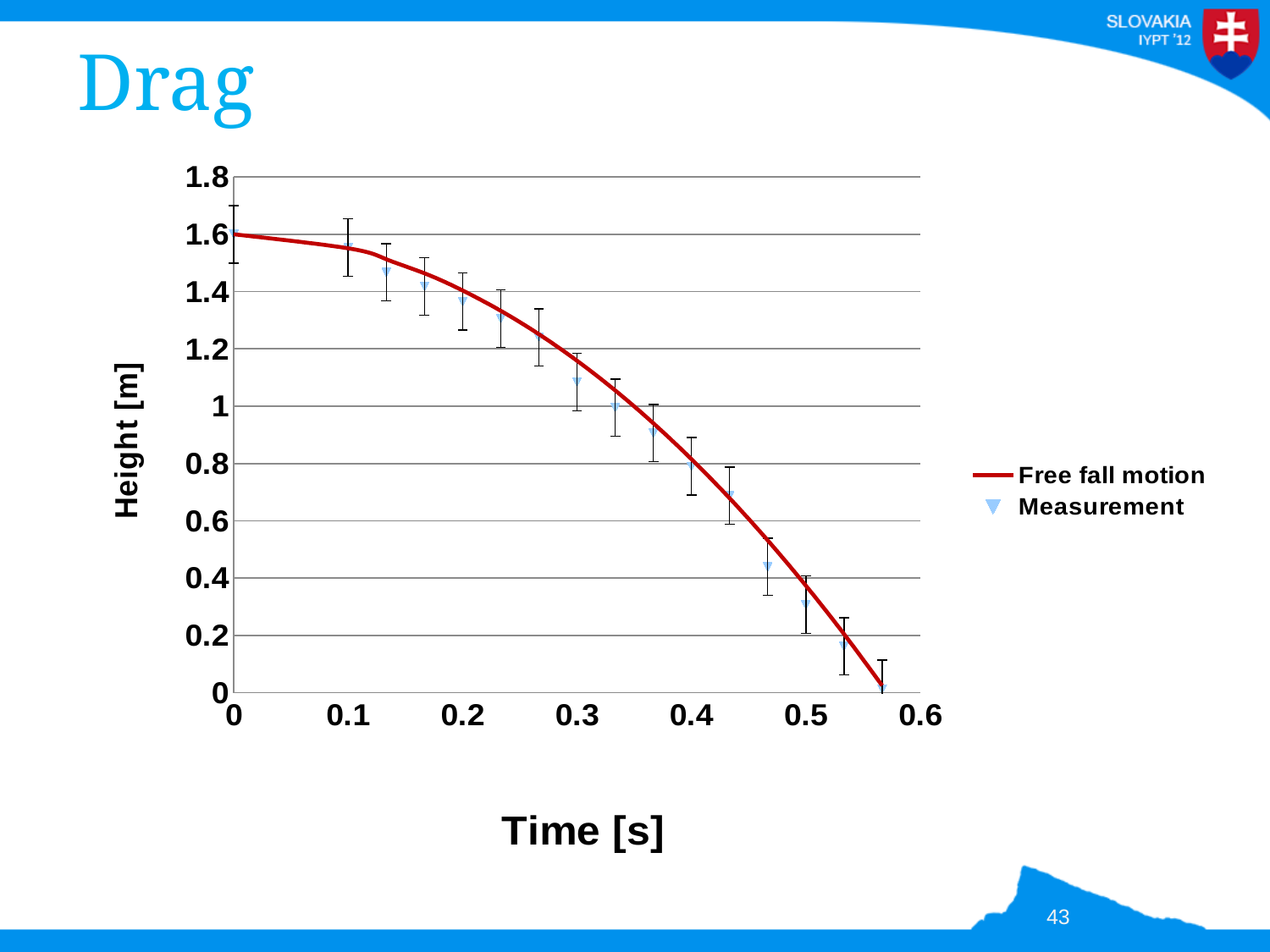
Does the height rise or fall as time increases along the x axis? fall At which time is the measured height highest? 0 Is the measured height at 0.1 s greater or less than 1.4? greater What are the two series named in the legend? Free fall motion, Measurement Is the measured height at 0.5 s greater or less than 0.4? less Which is larger, the measured height at 0.2 s or at 0.4 s? 0.2 s What is the label of the vertical axis? Height [m] Is the measured height at 0.3 s greater or less than 1.2? less How many series does the legend list? 2 What kind of chart is shown on the slide? line chart